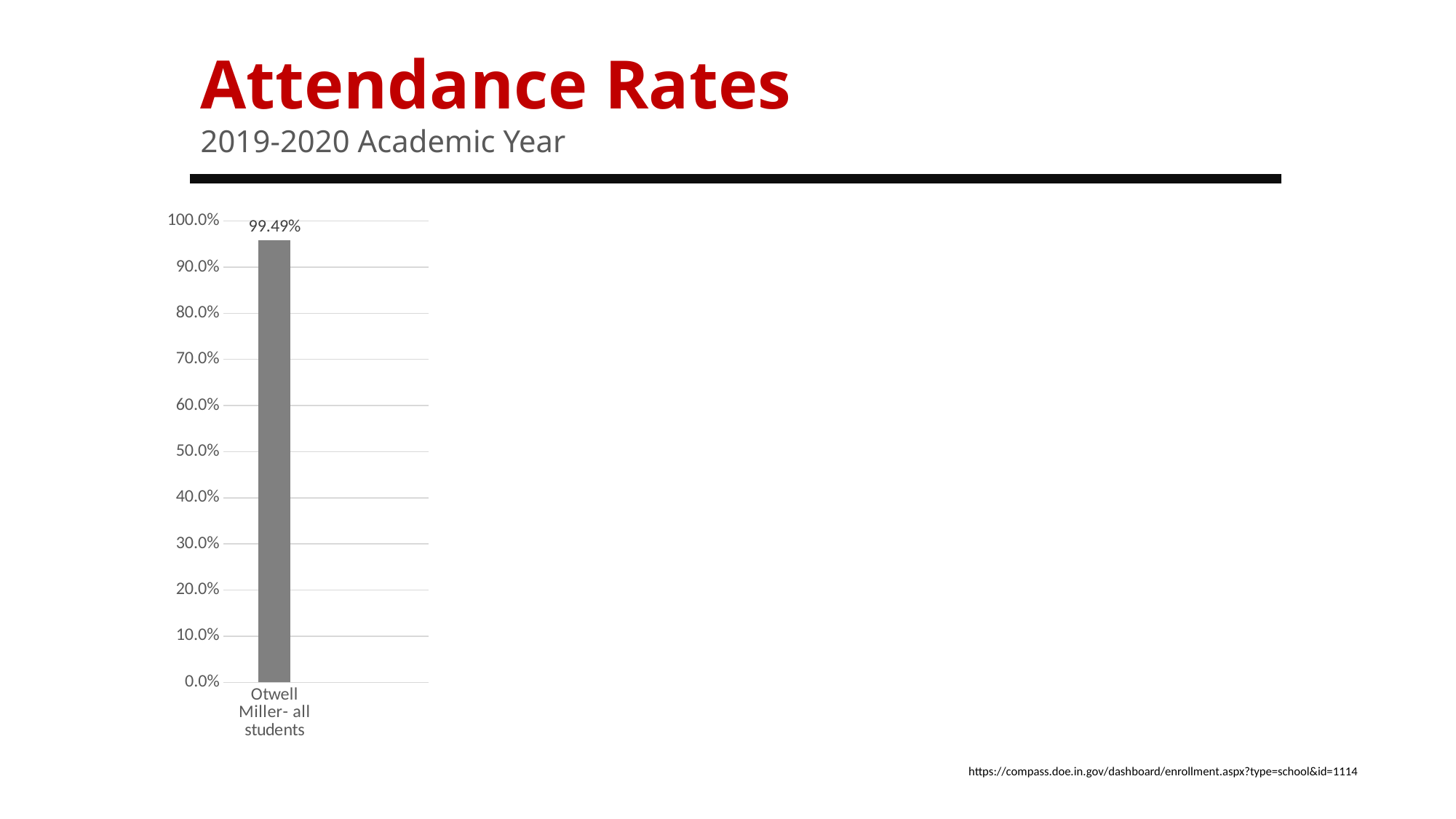
What is the label of the single category on the x axis? Otwell Miller- all students How many categories are plotted in the chart? 1 What kind of chart is shown on the slide? bar chart Is the value for Otwell Miller- all students greater or less than 50.0%? greater What is the highest value shown on the vertical axis? 100.0% Is the value for Otwell Miller- all students greater or less than 90.0%? greater What is the attendance rate shown for Otwell Miller- all students? 99.49%